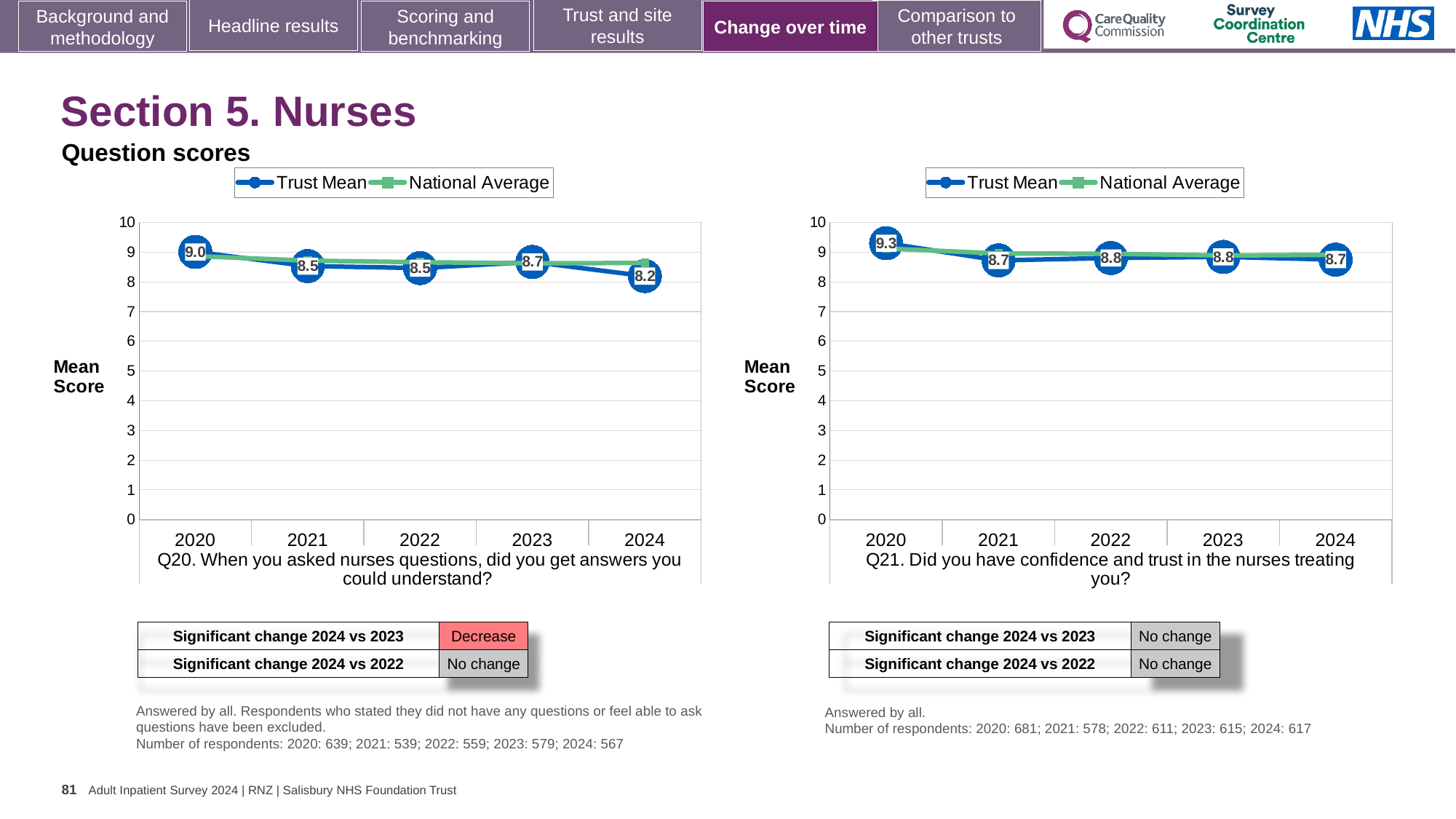
In the Q20 chart (left), what is the Trust Mean score for 2024? 8.2 In the Q21 chart (right), what is the Trust Mean score for 2021? 8.7 What kind of chart is the Q20 chart (left)? Line chart In the Q20 chart (left), which year has the highest Trust Mean score? 2020 In the Q20 chart (left), what is the difference between the Trust Mean scores for 2020 and 2024? 0.8 In the Q21 chart (right), what is the Trust Mean score for 2020? 9.3 In the Q20 chart (left), which year has the lowest Trust Mean score? 2024 In the Q20 chart (left), what is the Trust Mean score for 2020? 9.0 In the Q21 chart (right), what is the difference between the Trust Mean scores for 2020 and 2021? 0.6 How many series does the legend of the Q21 chart (right) list? 2 In the Q20 chart (left), is the Trust Mean score for 2023 or 2024 larger? 2023 In the Q21 chart (right), which year has the highest Trust Mean score? 2020